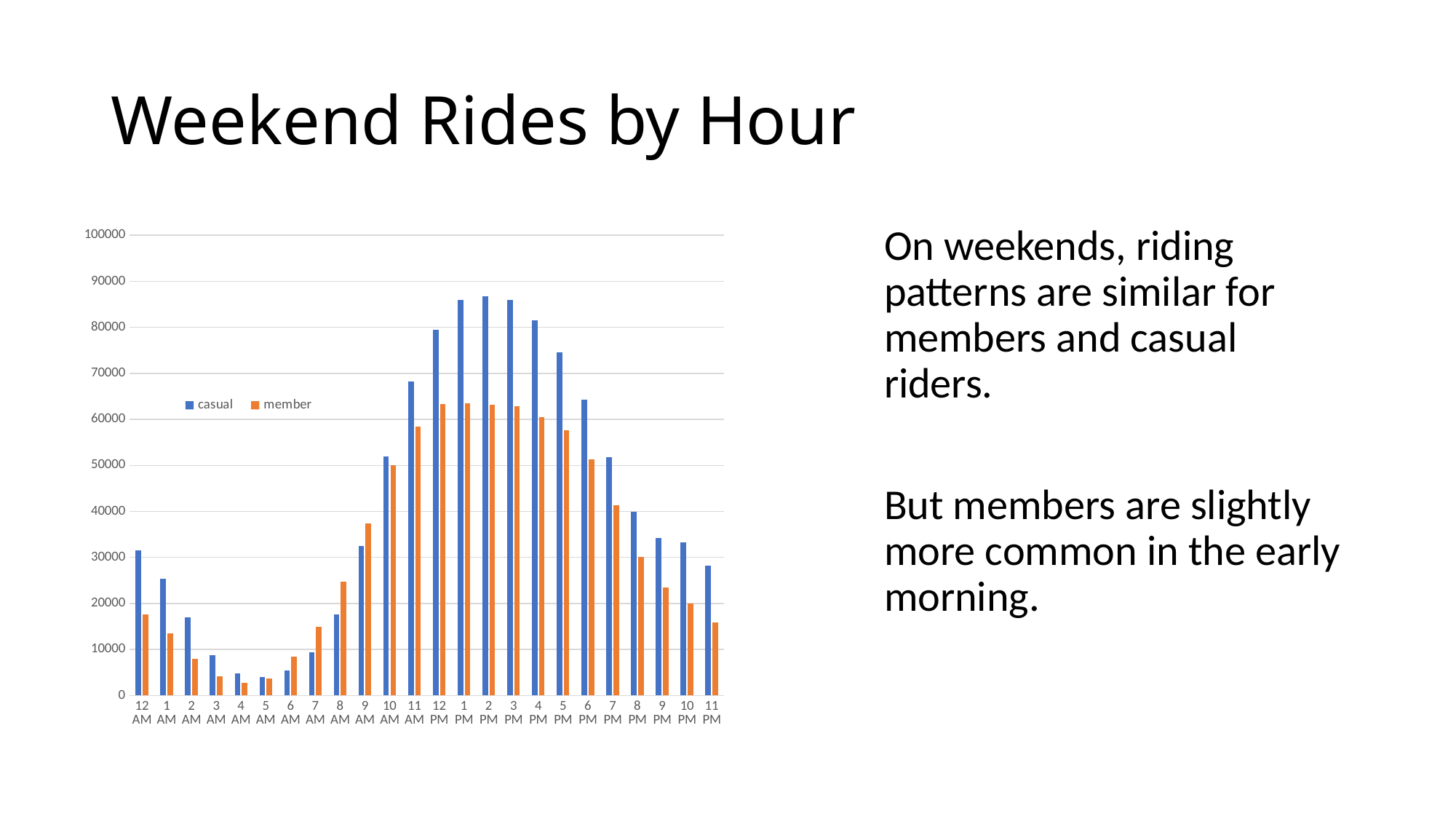
What kind of chart is shown on the slide? bar chart At 6 AM, which is larger, casual or member? member Is the casual value at 12 AM greater or less than 30000? greater Is the member value at 9 AM greater or less than 40000? less Is the member value at 5 PM greater or less than 60000? less Which series is shown in orange? member Do the casual values rise or fall from 12 AM to 5 AM? fall How many series does the legend list? 2 How many hour categories are shown on the x axis? 24 At 2 PM, which is larger, casual or member? casual